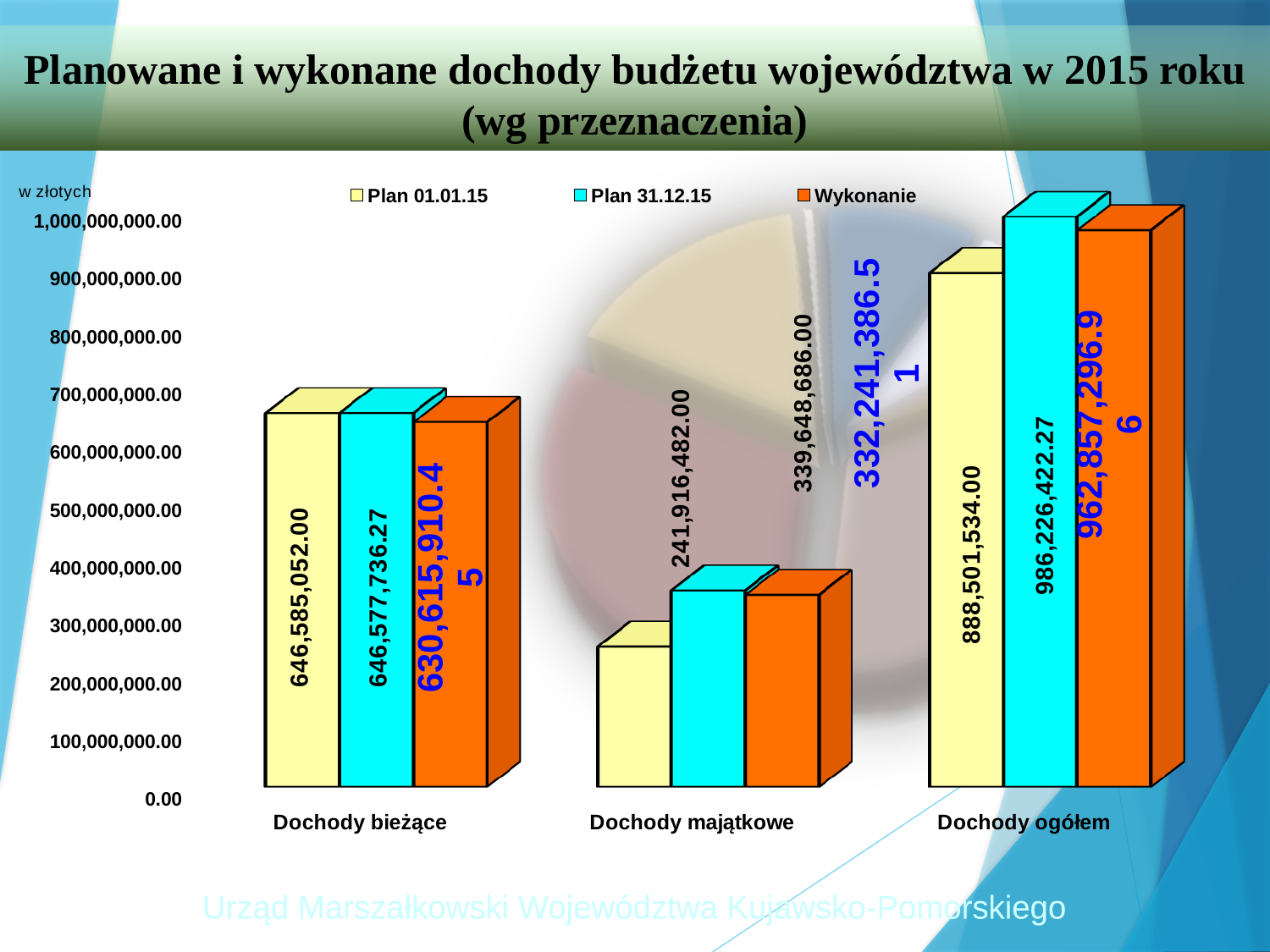
What is the Plan 01.01.15 value for Dochody bieżące? 646,585,052.00 Which category has the lowest Plan 01.01.15 value? Dochody majątkowe What is the Wykonanie value for Dochody majątkowe? 332,241,386.51 Is the Plan 01.01.15 value for Dochody majątkowe greater or less than 300,000,000.00? less Which is larger for Dochody ogółem: Plan 31.12.15 or Wykonanie? Plan 31.12.15 What is the Wykonanie value for Dochody ogółem? 962,857,296.96 What kind of chart is shown on the slide? bar chart Which category has the highest Wykonanie value? Dochody ogółem What is the Plan 31.12.15 value for Dochody ogółem? 986,226,422.27 How many categories are shown on the x axis? 3 What is the difference between the Plan 31.12.15 and Plan 01.01.15 values for Dochody majątkowe? 97,732,204.00 How many series does the legend list? 3